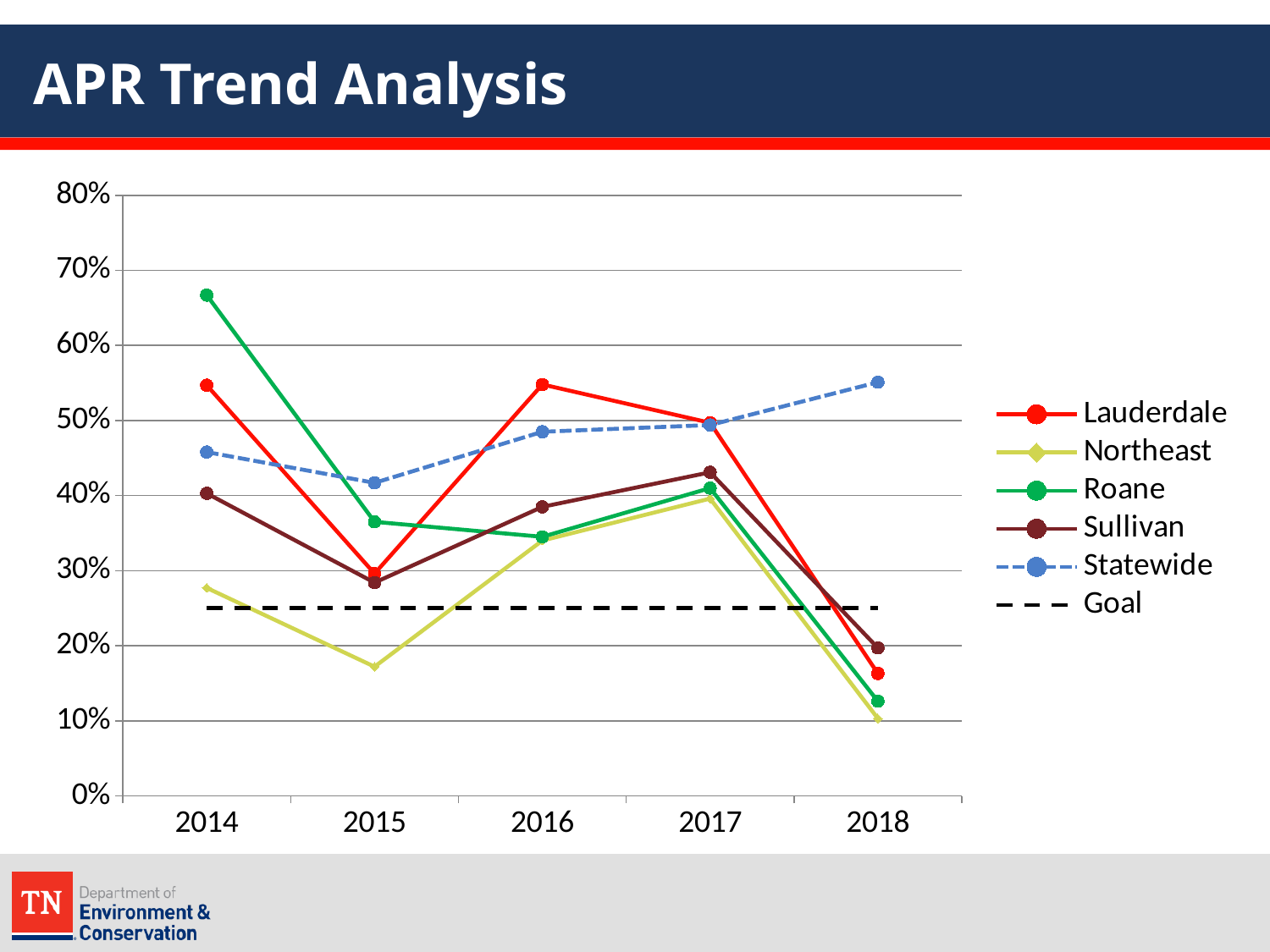
Is the Goal line greater or less than 30%? less Which series has the highest value in 2018? Statewide Which series has the highest value in 2014? Roane How many series does the legend list? 6 Which series has the lowest value in 2018? Northeast Does the Statewide series rise or fall from 2015 to 2018? rise Is the value for Northeast in 2015 greater or less than 20%? less How many years are shown on the x axis? 5 What kind of chart is shown on the slide? line chart Is the value for Roane in 2014 greater or less than 60%? greater Which series is drawn as a dashed black line? Goal In 2016, which is larger: Lauderdale or Sullivan? Lauderdale